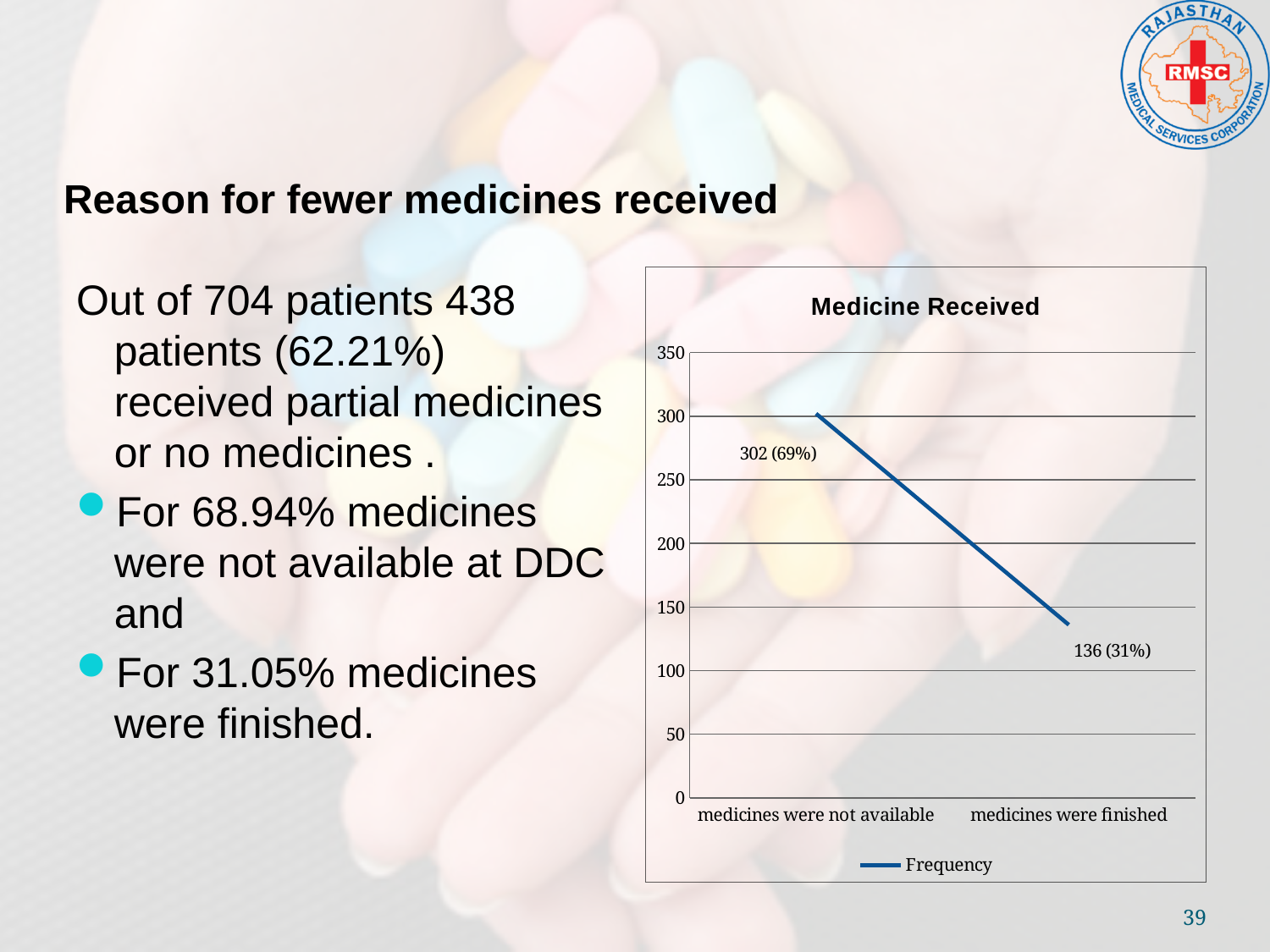
What kind of chart is shown on the slide? line chart What is the title of the chart? Medicine Received Is the value for 'medicines were finished' greater or less than 150? less How many categories are plotted on the x axis? 2 Which category has the lowest value? medicines were finished Which is larger, the value for 'medicines were not available' or 'medicines were finished'? medicines were not available How many series does the legend list? 1 What is the difference between the values for 'medicines were not available' and 'medicines were finished'? 166 What is the value for 'medicines were finished'? 136 (31%) Do the values rise or fall from left to right along the x axis? fall Which category has the highest value? medicines were not available What is the value for 'medicines were not available'? 302 (69%)